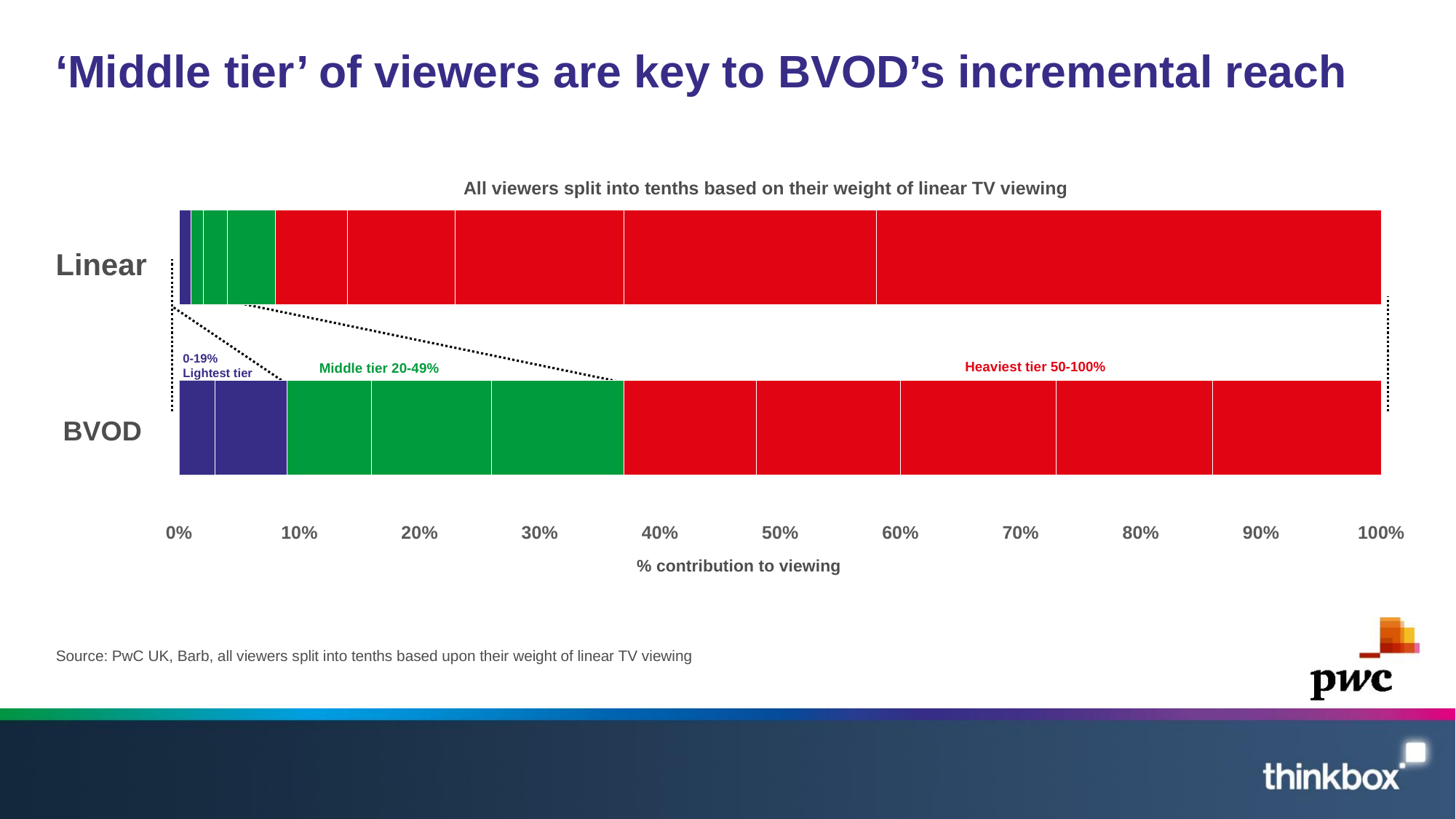
How many categories (bars) does the chart show? 2 Is the combined contribution of the lightest and middle tiers for BVOD greater or less than 30%? greater Is the combined contribution of the lightest and middle tiers for Linear greater or less than 10%? less Is the contribution of the lightest tier (0-19%) for BVOD greater or less than 10%? less Which colour represents the heaviest tier (50-100%) of viewers? Red Which bar, Linear or BVOD, has the larger contribution from the middle tier (20-49%) of viewers? BVOD What is the label of the x axis? % contribution to viewing What kind of chart is shown on the slide? Stacked bar chart Into how many segments is each bar split? 10 Which bar, Linear or BVOD, has the larger contribution from the heaviest tier (50-100%) of viewers? Linear